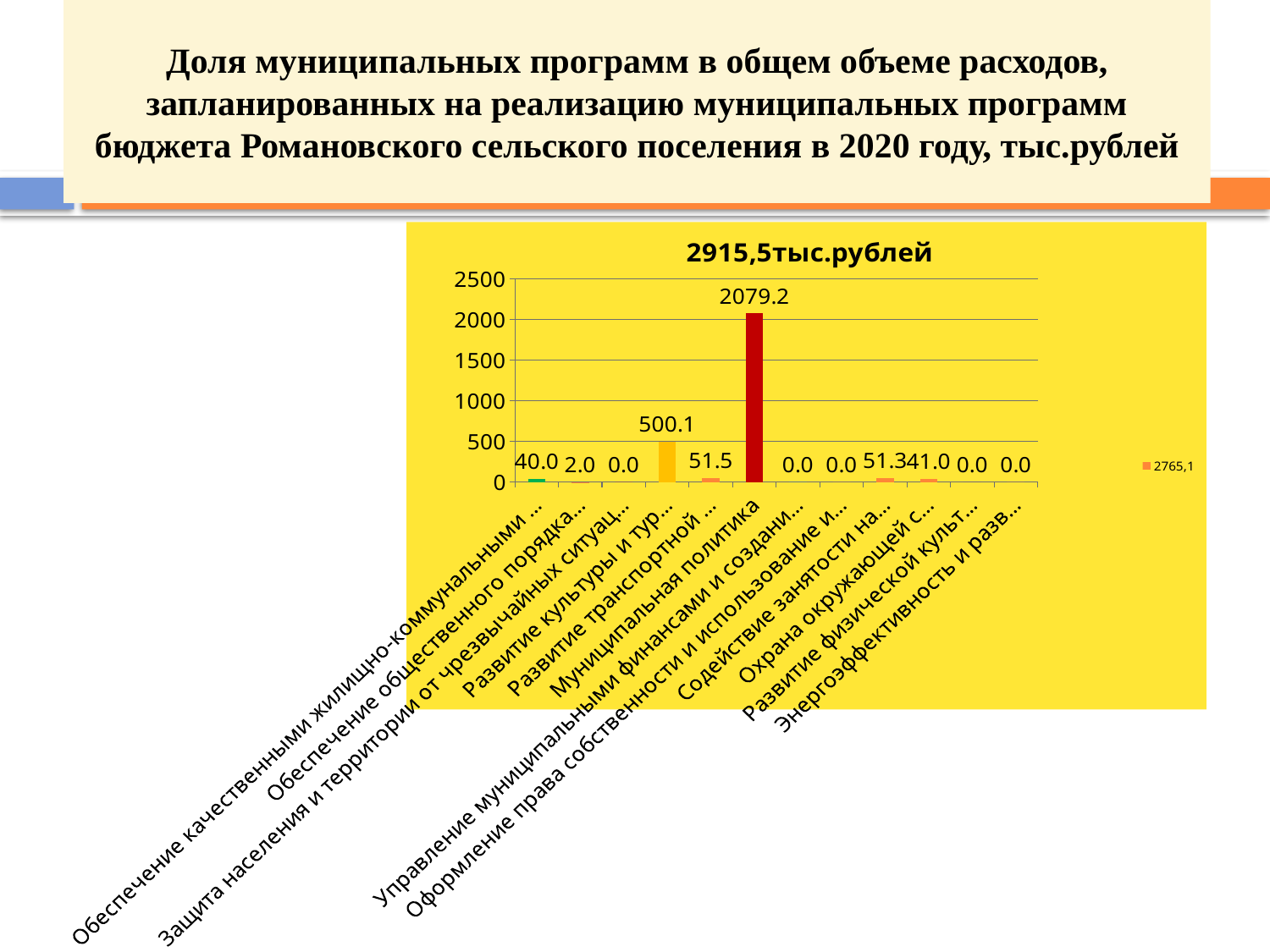
What is the value for Муниципальная политика? 2079.2 What is the value for Развитие культуры и тур...? 500.1 Which category has the highest value? Муниципальная политика Which is larger: the value for Развитие культуры и тур... or the value for Развитие транспортной ...? Развитие культуры и тур... Is the value for Муниципальная политика greater or less than 2000? greater What kind of chart is shown on the slide? bar chart How many categories are shown on the x axis? 12 What is the value for Обеспечение общественного порядка...? 2.0 What is the value for Развитие транспортной ...? 51.5 What is the difference between the values for Муниципальная политика and Развитие культуры и тур...? 1579.1 What is the title of the chart? 2915,5тыс.рублей How many series does the legend list? 1